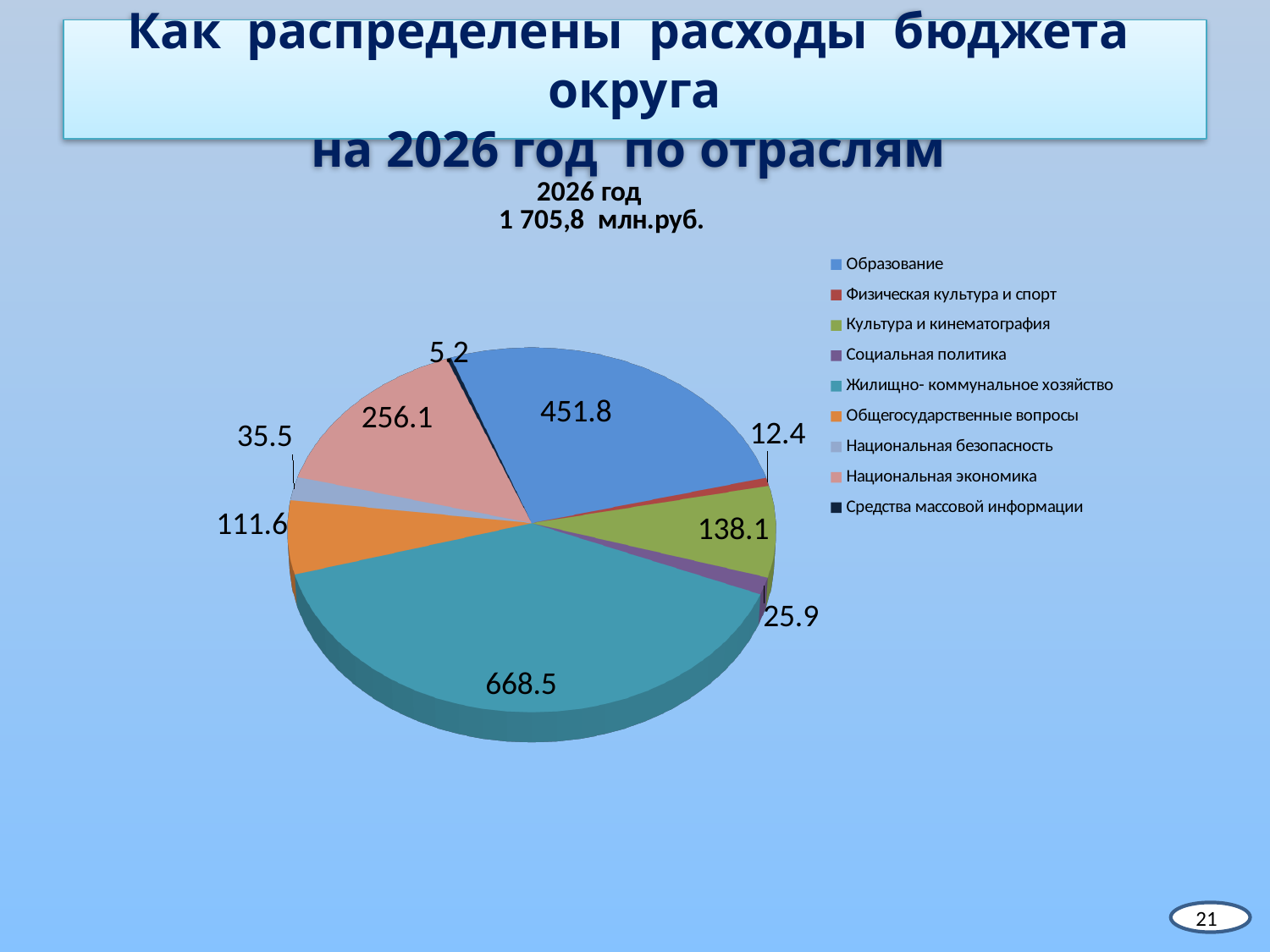
What is the value for Образование in the pie chart? 451.8 Which category has the smallest slice in the pie chart? Средства массовой информации What is the value for Жилищно- коммунальное хозяйство in the pie chart? 668.5 What is the value for Национальная экономика in the pie chart? 256.1 How many categories does the legend of the pie chart list? 9 What is the difference between the values for Общегосударственные вопросы and Национальная безопасность? 76.1 What total amount is stated above the pie chart for 2026? 1 705,8 млн.руб. Which category has the largest slice in the pie chart? Жилищно- коммунальное хозяйство Which is larger in the pie chart: Культура и кинематография or Общегосударственные вопросы? Культура и кинематография What kind of chart is shown on the slide? pie chart What is the value for Средства массовой информации in the pie chart? 5.2 What is the difference between the values for Жилищно- коммунальное хозяйство and Образование? 216.7